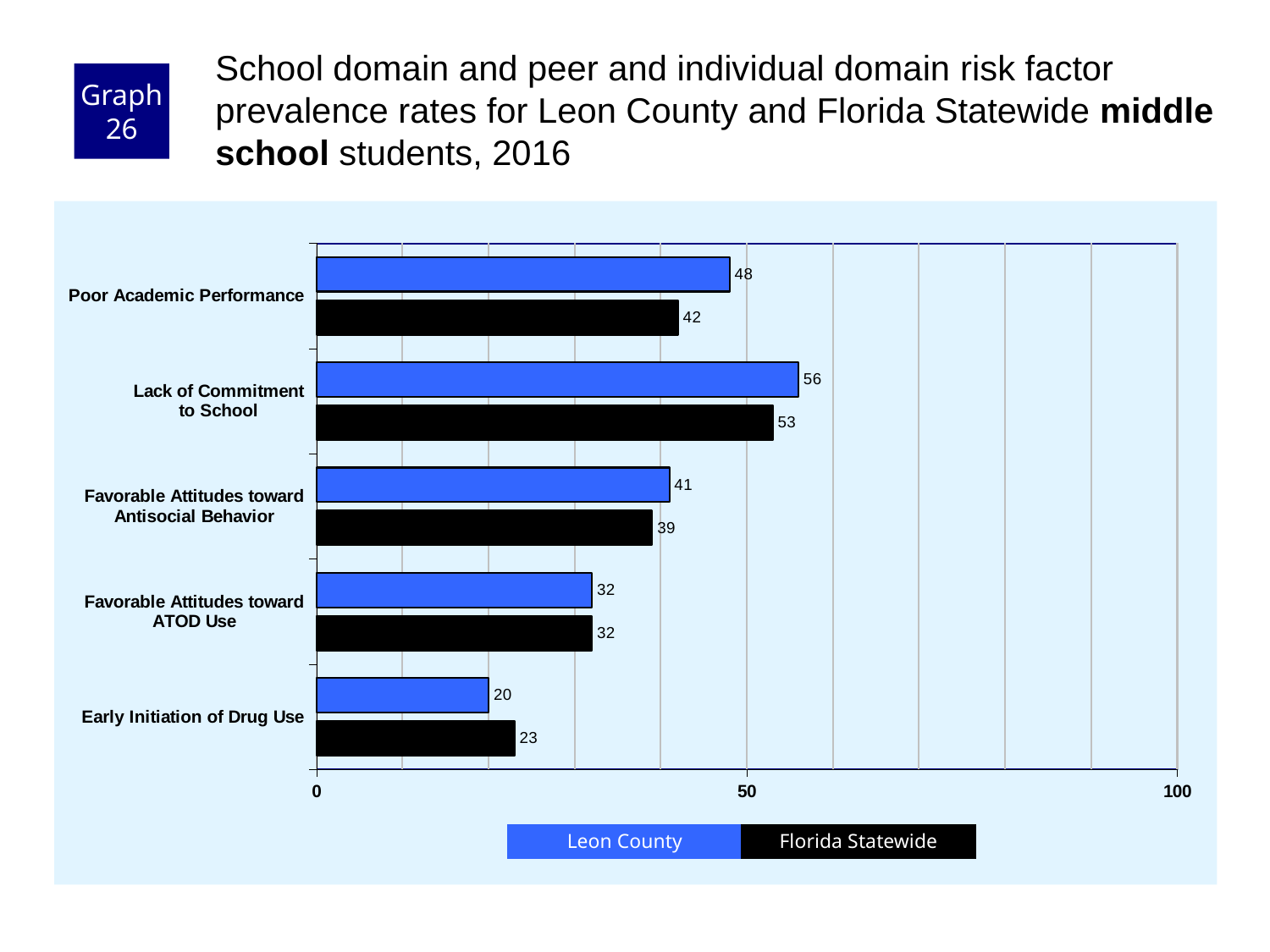
Is the Leon County value for Lack of Commitment to School greater or less than 50? greater For Early Initiation of Drug Use, which is larger: the Leon County value or the Florida Statewide value? Florida Statewide Which risk factor has the highest Leon County value? Lack of Commitment to School Which risk factor has the lowest Florida Statewide value? Early Initiation of Drug Use How many series does the legend list? 2 What is the Florida Statewide value for Lack of Commitment to School? 53 What is the Leon County value for Early Initiation of Drug Use? 20 What kind of chart is shown on the slide? Bar chart What is the difference between the Leon County and Florida Statewide values for Poor Academic Performance? 6 What is the Leon County value for Poor Academic Performance? 48 Which colour represents Florida Statewide in the legend? Black How many risk factor categories are shown on the chart? 5